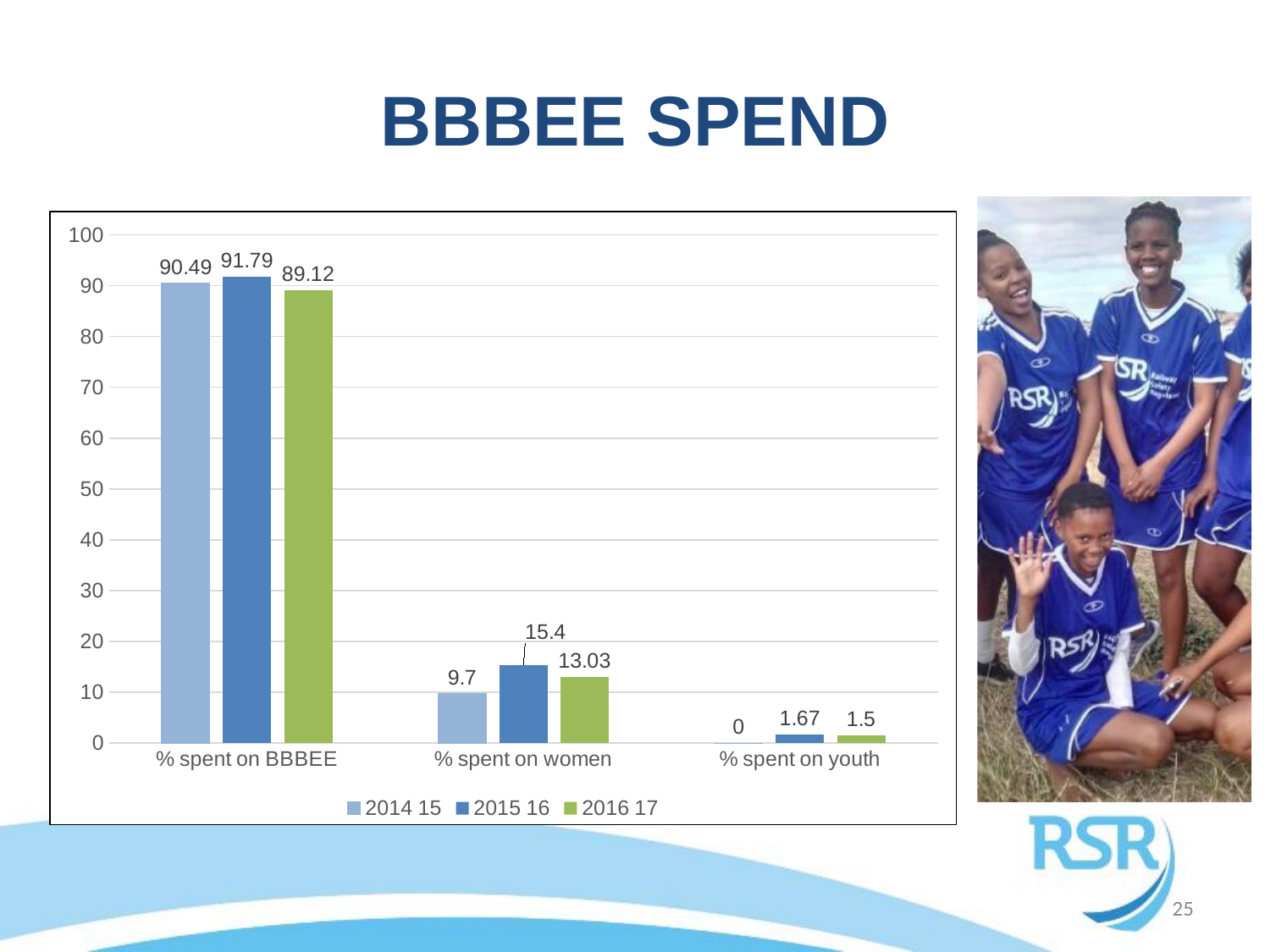
What is the value for 2016 17 in the % spent on women category? 13.03 Which is larger: the 2015 16 value or the 2016 17 value for % spent on youth? 2015 16 How many series does the legend list? 3 What kind of chart is shown on the slide? bar chart What is the difference between the 2015 16 and 2014 15 values for % spent on women? 5.7 What is the value for 2014 15 in the % spent on youth category? 0 What is the title of the slide containing the chart? BBBEE SPEND How many categories are shown on the x axis? 3 Is the value for 2014 15 in % spent on BBBEE greater or less than 80? greater What is the value for 2015 16 in the % spent on BBBEE category? 91.79 Which series has the lowest value in the % spent on BBBEE category? 2016 17 Which series has the highest value in the % spent on women category? 2015 16